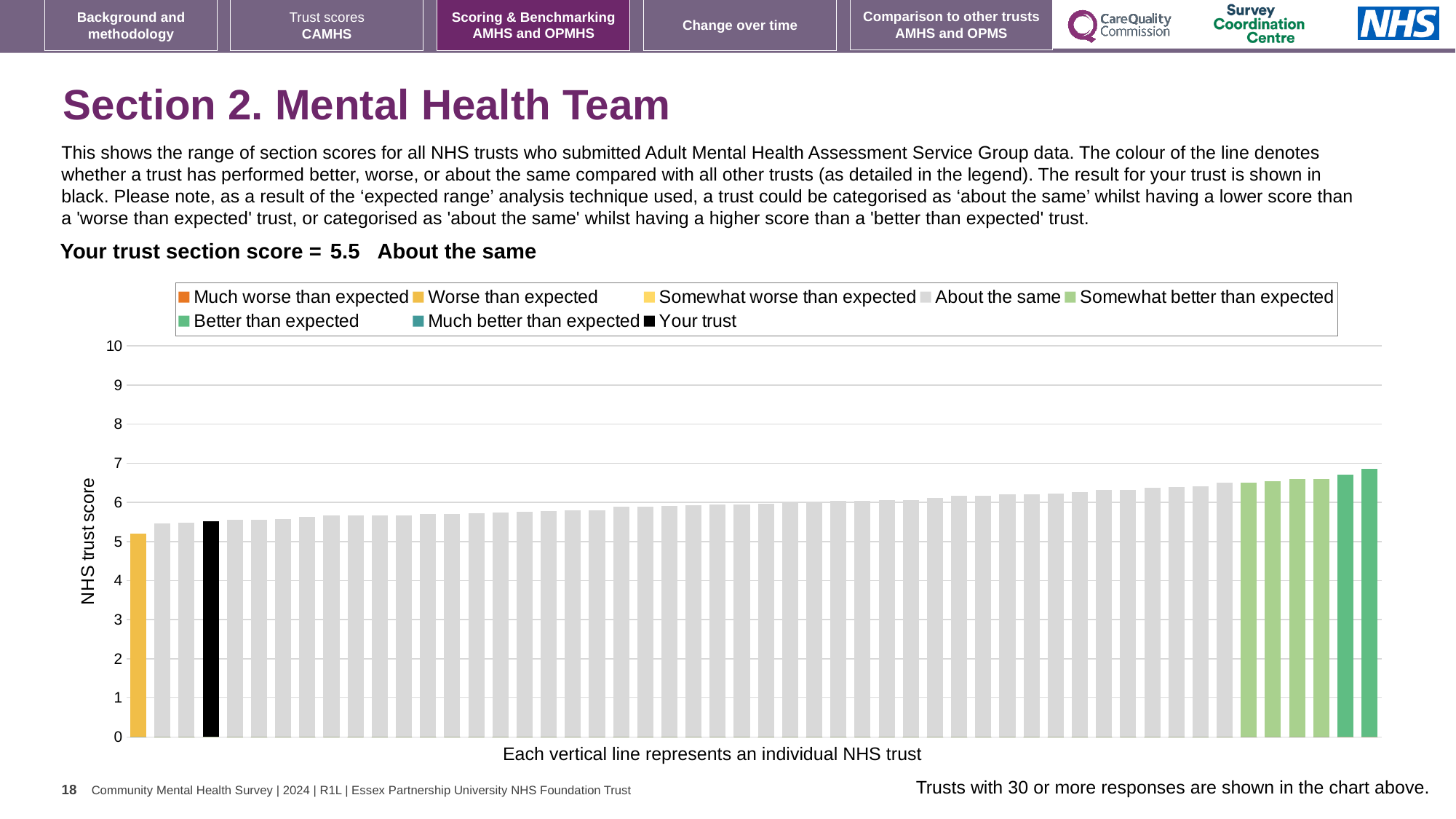
Which is larger: the value for your trust (black bar) or the value for the rightmost bar? the rightmost bar Is the value for the highest-scoring trust (rightmost bar) greater or less than 7? less What is the section score for your trust? 5.5 Which benchmarking category is your trust placed in for this section? About the same Is the value for your trust greater or less than 5? greater What is the label on the vertical axis of the chart? NHS trust score What kind of chart is shown on the slide? bar chart Is the value for the lowest-scoring trust (leftmost bar) greater or less than 5? greater How many entries does the chart legend list? 8 Do the bar values rise or fall from left to right along the x axis? rise What colour is used for the 'Your trust' bar in the chart? black